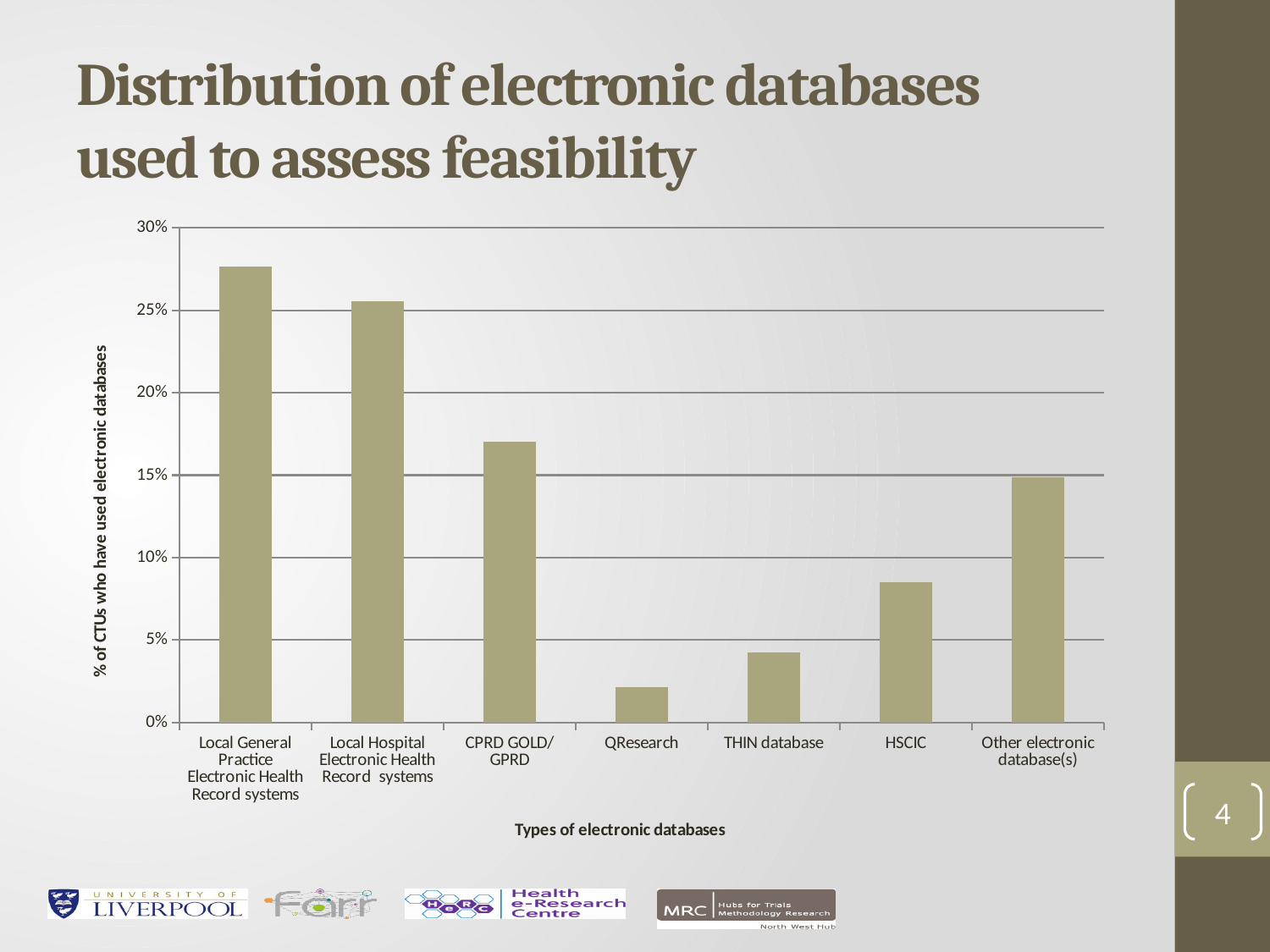
Is the value for Local Hospital Electronic Health Record systems greater or less than 20%? greater Which has a higher value, Other electronic database(s) or CPRD GOLD/GPRD? CPRD GOLD/GPRD What kind of chart is shown on the slide? bar chart Is the value for Local General Practice Electronic Health Record systems greater or less than 25%? greater Which type of electronic database has the highest percentage of CTUs? Local General Practice Electronic Health Record systems Is the value for HSCIC greater or less than 10%? less Which has a higher value, HSCIC or THIN database? HSCIC What is the label of the y axis? % of CTUs who have used electronic databases How many types of electronic databases are shown on the x axis? 7 Which type of electronic database has the lowest percentage of CTUs? QResearch